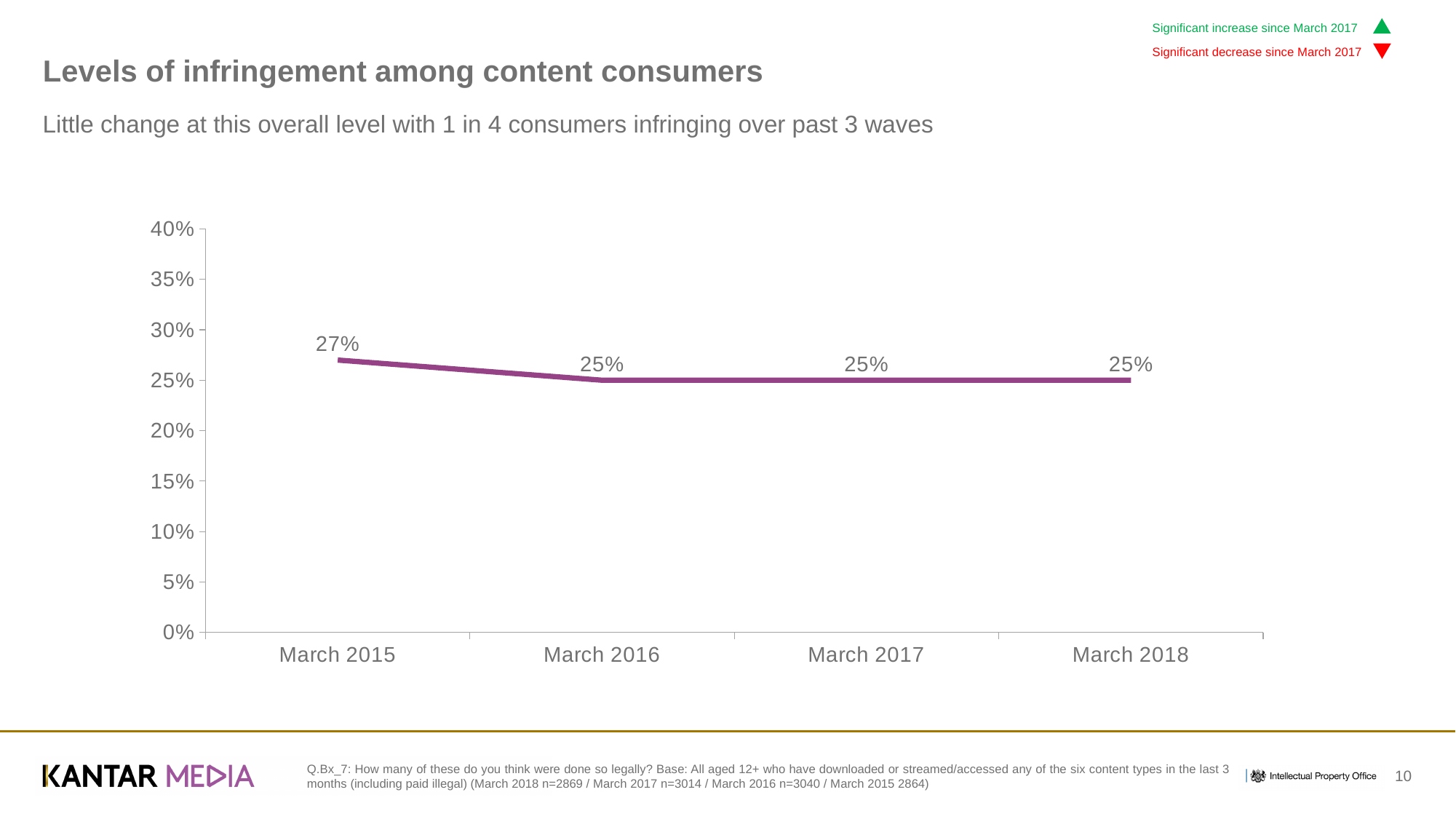
What is the value for March 2015? 27% Which is larger, the value for March 2015 or the value for March 2017? March 2015 What is the title of the slide? Levels of infringement among content consumers Is the value for March 2015 greater or less than 30%? less What is the highest value shown on the vertical axis? 40% What is the value for March 2016? 25% Which time point has the highest value? March 2015 What kind of chart is shown on the slide? line chart Do the values rise or fall from March 2015 to March 2016? fall What is the value for March 2018? 25% How many time points are plotted on the chart? 4 What is the difference between the March 2015 value and the March 2016 value? 2%